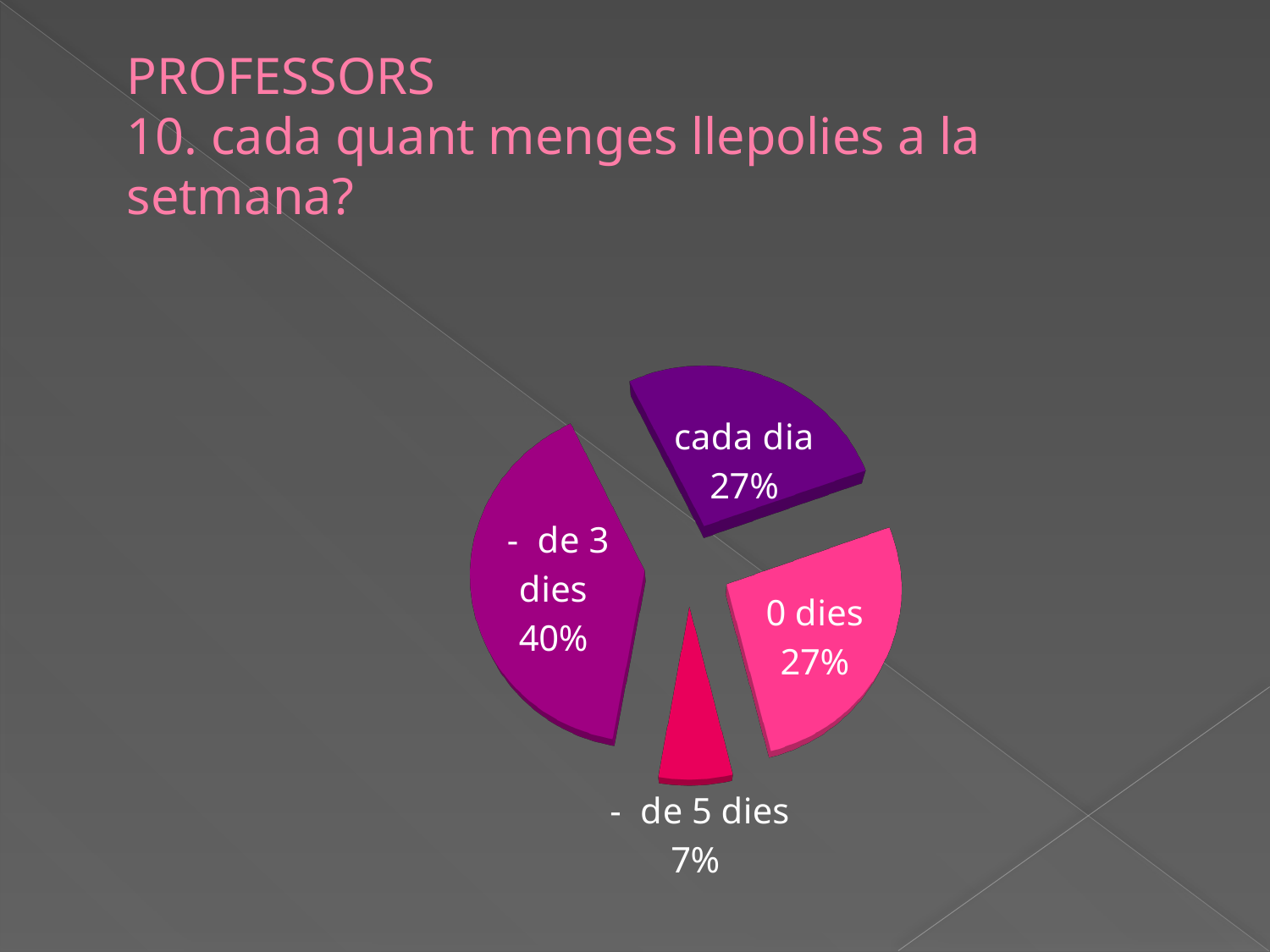
What share of the pie does the "0 dies" slice represent? 27% What is the difference in percentage points between the "- de 3 dies" slice and the "- de 5 dies" slice? 33% What question does the slide title say the chart answers? 10. cada quant menges llepolies a la setmana? Which is larger, the "- de 3 dies" slice or the "cada dia" slice? - de 3 dies What kind of chart is shown on the slide? pie chart What is the difference in percentage points between the "- de 3 dies" slice and the "0 dies" slice? 13% How many slices does the pie chart have? 4 Which slice of the pie is the smallest? - de 5 dies Which slice of the pie is the largest? - de 3 dies What share of the pie does the "cada dia" slice represent? 27% What share of the pie does the "- de 3 dies" slice represent? 40%